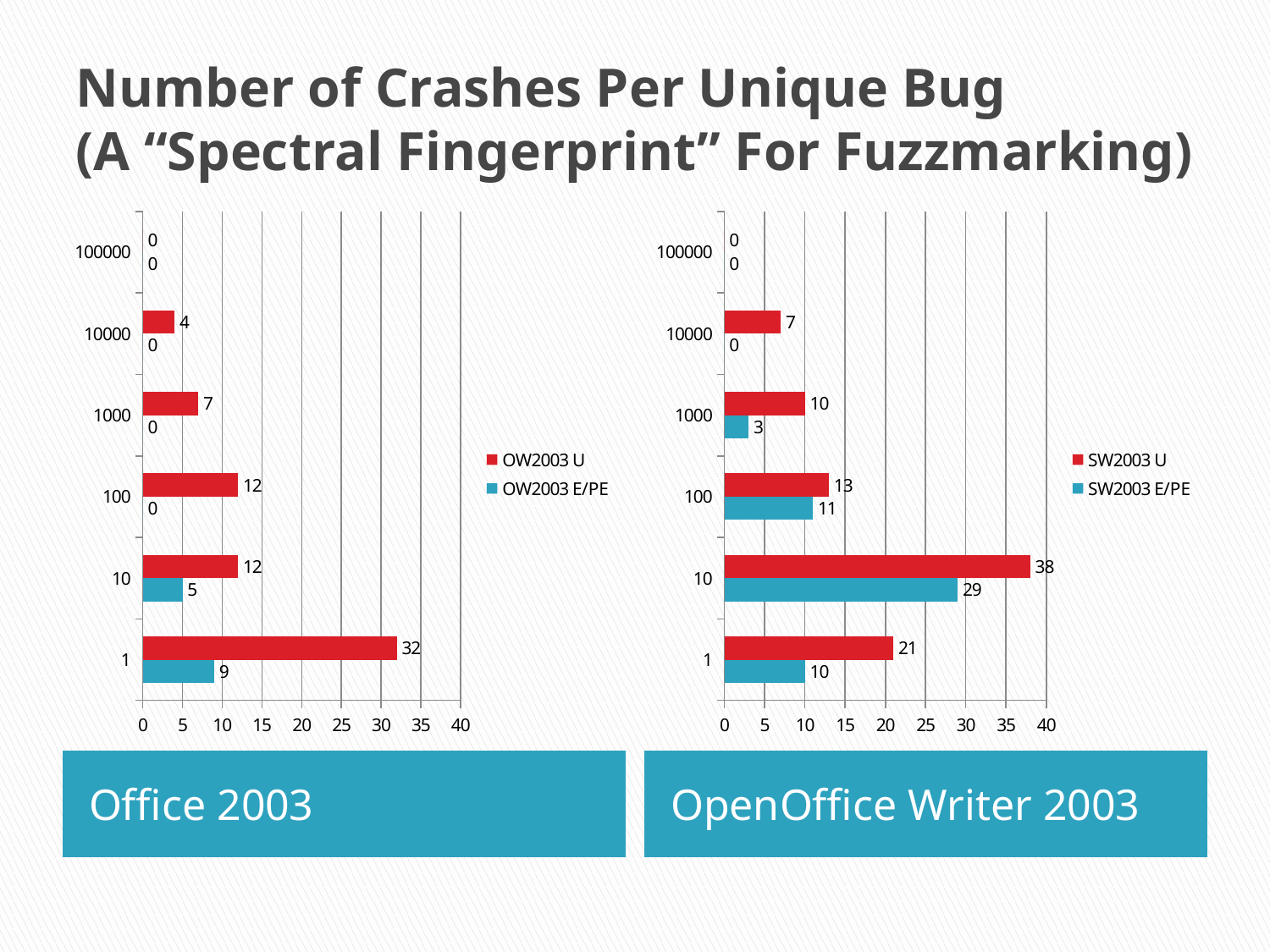
In the Office 2003 chart, what is the difference between OW2003 U at category 1 and OW2003 U at category 10? 20 How many series does the legend of the OpenOffice Writer 2003 chart list? 2 In the OpenOffice Writer 2003 chart, what is the difference between SW2003 U and SW2003 E/PE at category 10? 9 In the OpenOffice Writer 2003 chart, which category has the highest SW2003 U value? 10 In the OpenOffice Writer 2003 chart, what is the value for SW2003 E/PE at category 10? 29 In the OpenOffice Writer 2003 chart, what is the value for SW2003 U at category 1000? 10 In the Office 2003 chart, which category has the highest OW2003 E/PE value? 1 How many categories are shown on the y axis of the Office 2003 chart? 6 In the Office 2003 chart, what is the value for OW2003 U at category 1? 32 What type of chart is the Office 2003 chart? Bar chart Which is larger: OW2003 U at category 1 in the Office 2003 chart, or SW2003 U at category 1 in the OpenOffice Writer 2003 chart? OW2003 U at category 1 in the Office 2003 chart In the Office 2003 chart, what is the value for OW2003 E/PE at category 10? 5